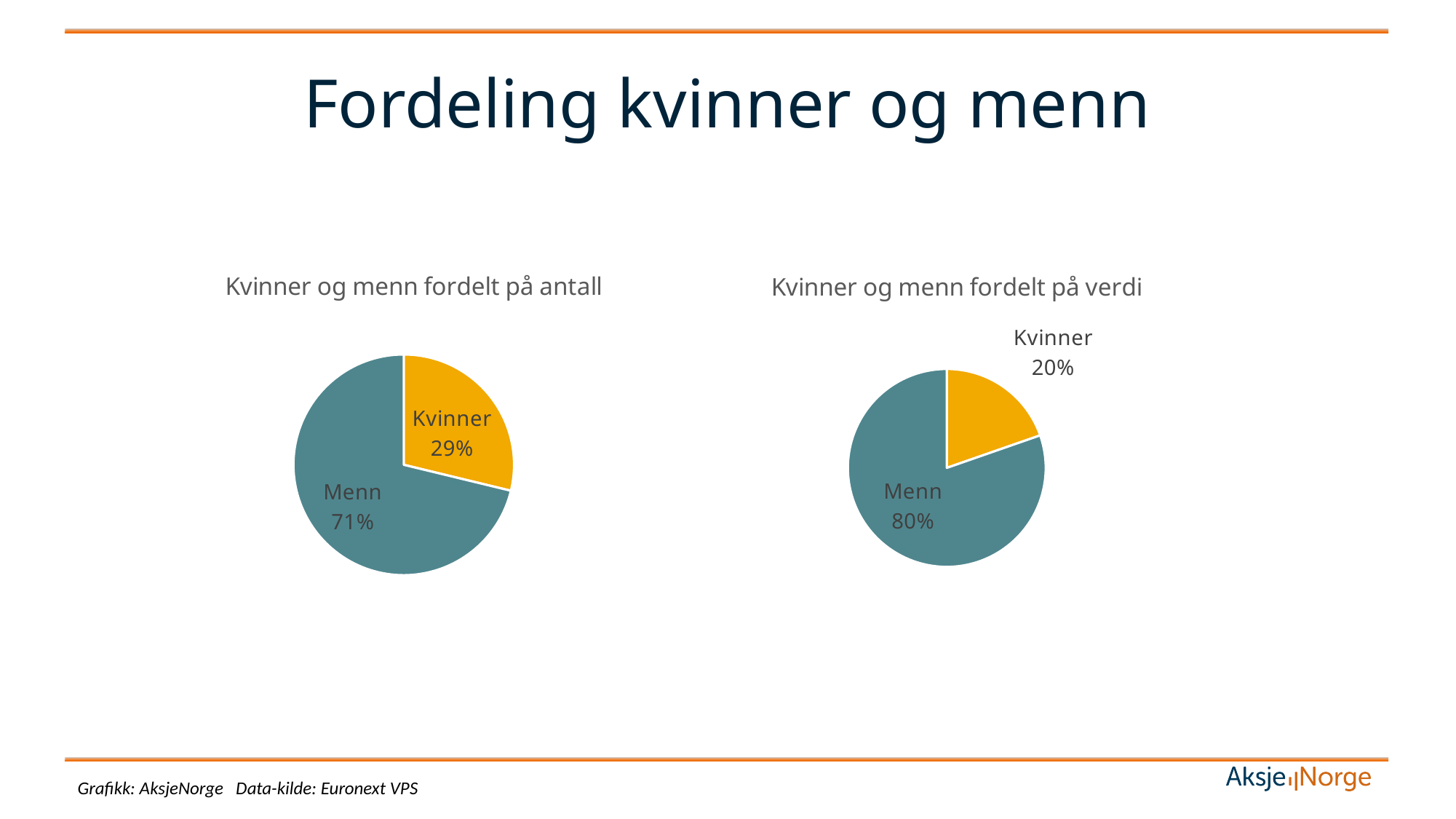
In the chart titled "Kvinner og menn fordelt på antall", what is the difference in percentage points between Menn and Kvinner? 42 How many slices does the chart titled "Kvinner og menn fordelt på antall" have? 2 In the chart titled "Kvinner og menn fordelt på antall", what share of the pie is Kvinner? 29% In the chart titled "Kvinner og menn fordelt på antall", what share of the pie is Menn? 71% In the chart titled "Kvinner og menn fordelt på antall", what colour is the Kvinner slice? Yellow What kind of chart is the chart titled "Kvinner og menn fordelt på verdi"? Pie chart Is the Kvinner share larger in the chart titled "Kvinner og menn fordelt på antall" or in the chart titled "Kvinner og menn fordelt på verdi"? Kvinner og menn fordelt på antall In the chart titled "Kvinner og menn fordelt på verdi", which slice is the smallest? Kvinner In the chart titled "Kvinner og menn fordelt på verdi", what is the difference in percentage points between Menn and Kvinner? 60 In the chart titled "Kvinner og menn fordelt på verdi", what share of the pie is Menn? 80% In the chart titled "Kvinner og menn fordelt på antall", which slice is the largest? Menn